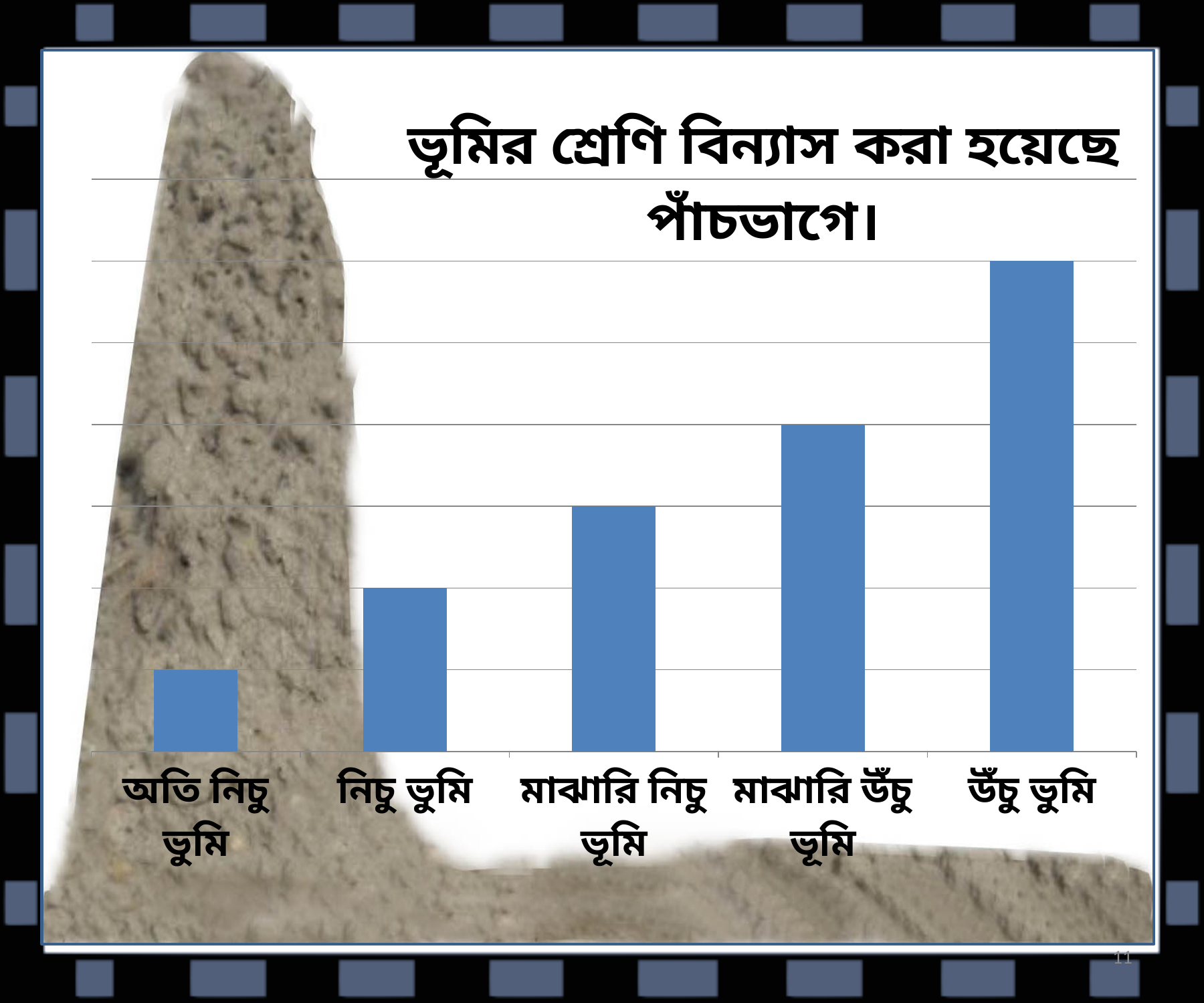
What is the label of the third category from the left on the x axis? মাঝারি নিচু ভূমি Which bar is taller: মাঝারি উঁচু ভূমি or উঁচু ভুমি? উঁচু ভুমি What is the title of the chart? ভূমির শ্রেণি বিন্যাস করা হয়েছে পাঁচভাগে। Which bar is taller: নিচু ভুমি or মাঝারি নিচু ভূমি? মাঝারি নিচু ভূমি What colour are the bars in the chart? blue Which bar is shorter: অতি নিচু ভুমি or নিচু ভুমি? অতি নিচু ভুমি How many categories are plotted on the x axis of the chart? 5 What kind of chart is shown on the slide? bar chart Which category has the shortest bar in the chart? অতি নিচু ভুমি Do the bar heights rise or fall from left to right along the x axis? rise Which category has the tallest bar in the chart? উঁচু ভুমি